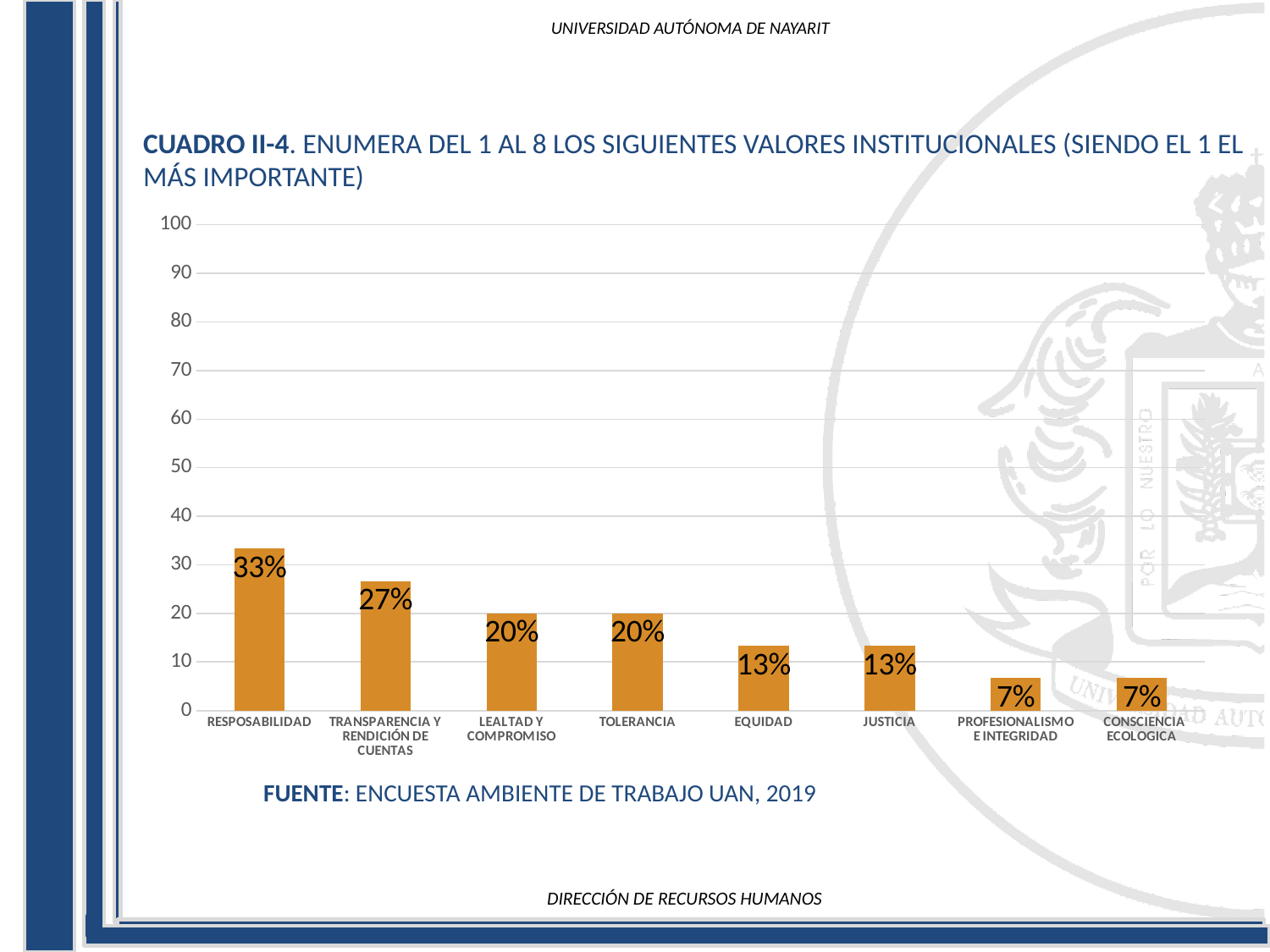
Which is larger, the value for LEALTAD Y COMPROMISO or the value for PROFESIONALISMO E INTEGRIDAD? LEALTAD Y COMPROMISO What is the value for CONSCIENCIA ECOLOGICA? 7% What is the difference between the values for RESPOSABILIDAD and TRANSPARENCIA Y RENDICIÓN DE CUENTAS? 6% How many categories are shown on the x axis? 8 What is the value for TRANSPARENCIA Y RENDICIÓN DE CUENTAS? 27% What is the difference between the values for TOLERANCIA and JUSTICIA? 7% What is the value for RESPOSABILIDAD? 33% What is the value for EQUIDAD? 13% What kind of chart is shown on the slide? bar chart Is the value for RESPOSABILIDAD greater or less than 30? greater What source is cited below the chart? ENCUESTA AMBIENTE DE TRABAJO UAN, 2019 Which category has the highest value? RESPOSABILIDAD